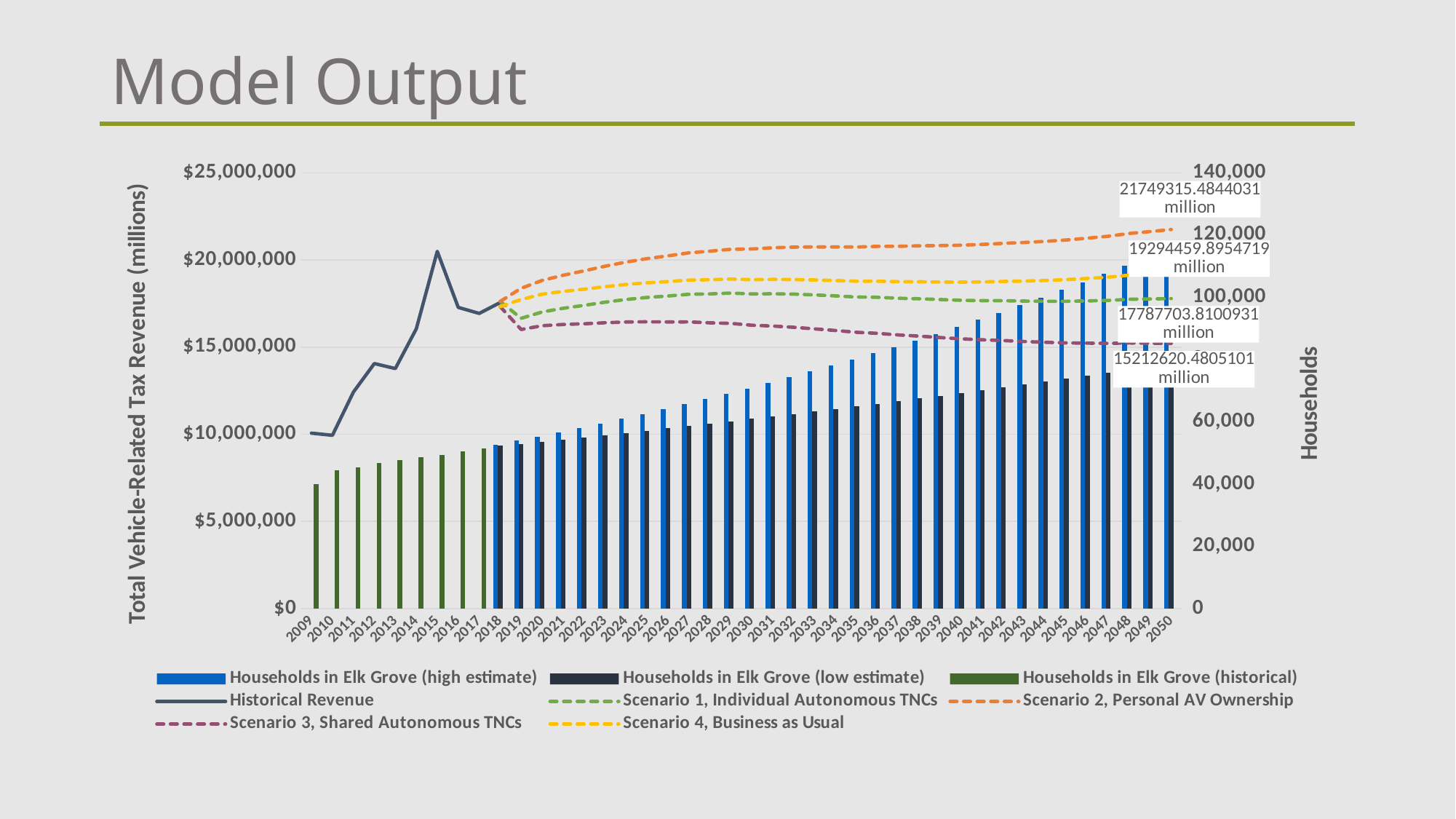
What kind of chart is shown on the slide? Combination bar and line chart Is the Historical Revenue value in 2015 greater or less than $20,000,000? greater Do the Households in Elk Grove (high estimate) bars rise or fall from 2018 to 2050? Rise Which scenario has the lowest revenue value at 2050? Scenario 3, Shared Autonomous TNCs What is the data label shown for Scenario 3, Shared Autonomous TNCs at the end of the projection (2050)? 15212620.4805101 million What is the data label shown for Scenario 4, Business as Usual at 2050? 19294459.8954719 million What is the data label shown for Scenario 2, Personal AV Ownership at the end of the projection (2050)? 21749315.4844031 million Which scenario has the highest revenue value at 2050? Scenario 2, Personal AV Ownership At 2050, which is larger: Scenario 4, Business as Usual or Scenario 1, Individual Autonomous TNCs? Scenario 4, Business as Usual What is the difference between the 2050 data labels for Scenario 2 and Scenario 3? 6536695.003893 million How many series does the legend list? 8 Is the Households in Elk Grove (historical) value for 2017 greater or less than 60,000? less